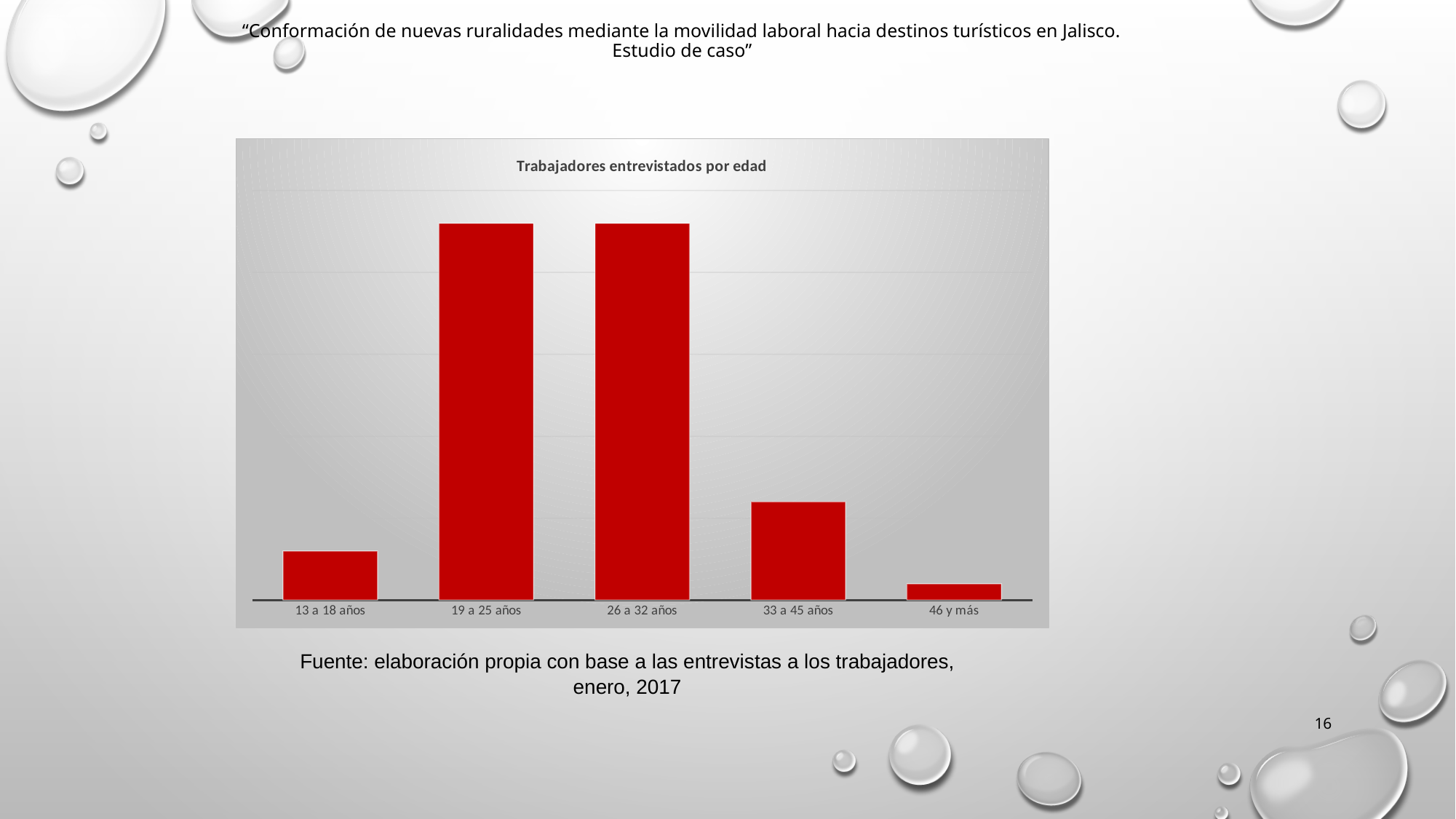
Which is larger, the value for 19 a 25 años or the value for 46 y más? 19 a 25 años Which is larger, the value for 26 a 32 años or the value for 33 a 45 años? 26 a 32 años Which age category has the lowest number of interviewed workers? 46 y más What colour are the bars in the chart? red What kind of chart is shown on the slide? bar chart How many age categories are shown on the x axis of the chart? 5 Which is larger, the value for 13 a 18 años or the value for 46 y más? 13 a 18 años What is the title of the chart? Trabajadores entrevistados por edad What is the label of the first category on the x axis? 13 a 18 años